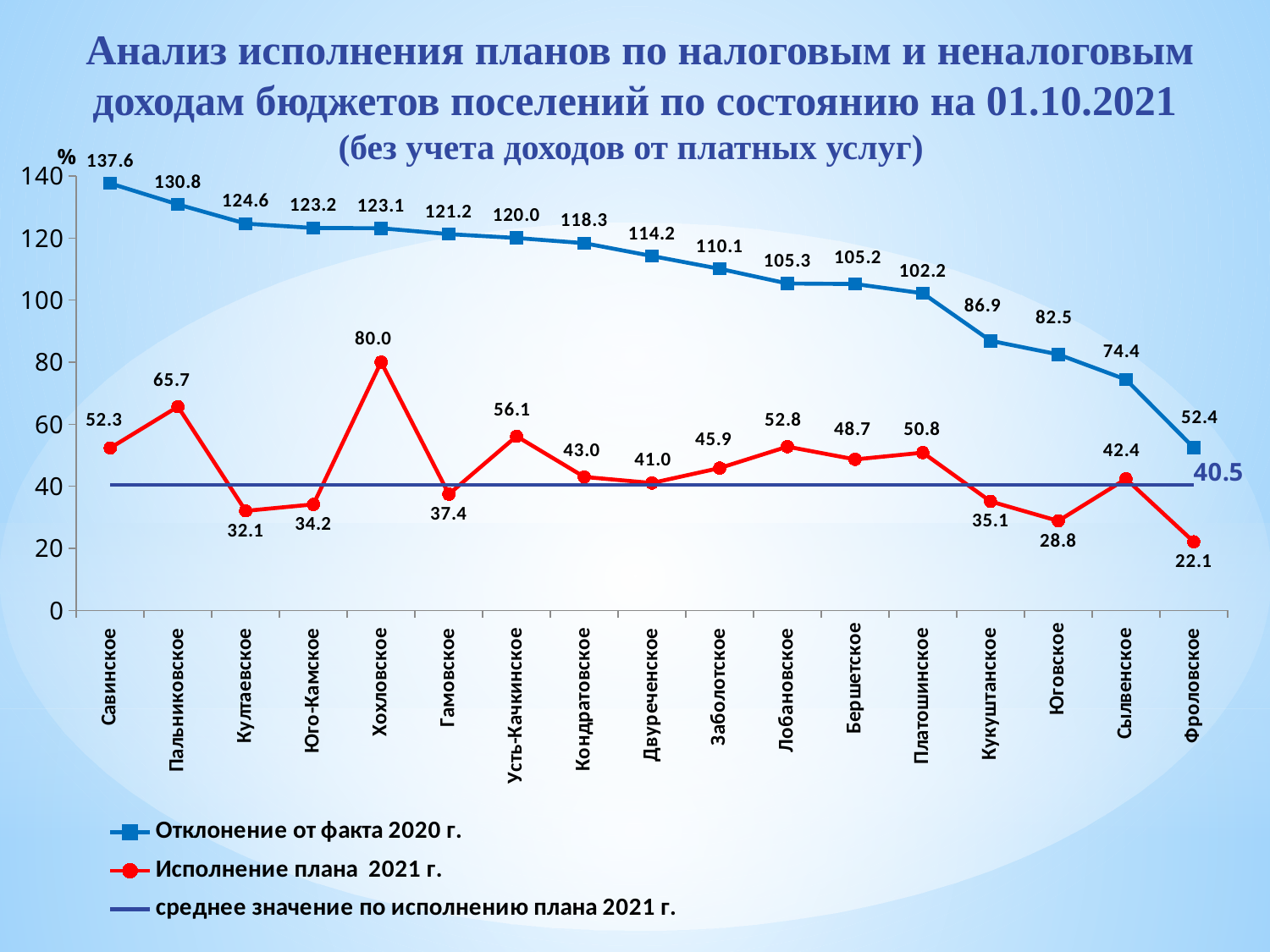
What value is shown for the average line "среднее значение по исполнению плана 2021 г."? 40.5 What is the value of "Исполнение плана 2021 г." for Хохловское? 80.0 What is the value of "Отклонение от факта 2020 г." for Кукуштанское? 86.9 Which settlement has the highest value for "Исполнение плана 2021 г."? Хохловское What is the difference between the "Отклонение от факта 2020 г." values for Савинское and Фроловское? 85.2 Which settlement has the lowest value for "Отклонение от факта 2020 г."? Фроловское Which is larger for Пальниковское: "Отклонение от факта 2020 г." or "Исполнение плана 2021 г."? Отклонение от факта 2020 г. Is the "Исполнение плана 2021 г." value for Юговское greater or less than 40? less What kind of chart is shown on the slide? line chart How many series does the legend list? 3 Does the "Отклонение от факта 2020 г." series rise or fall from left to right along the x axis? fall How many settlements are shown on the x axis? 17